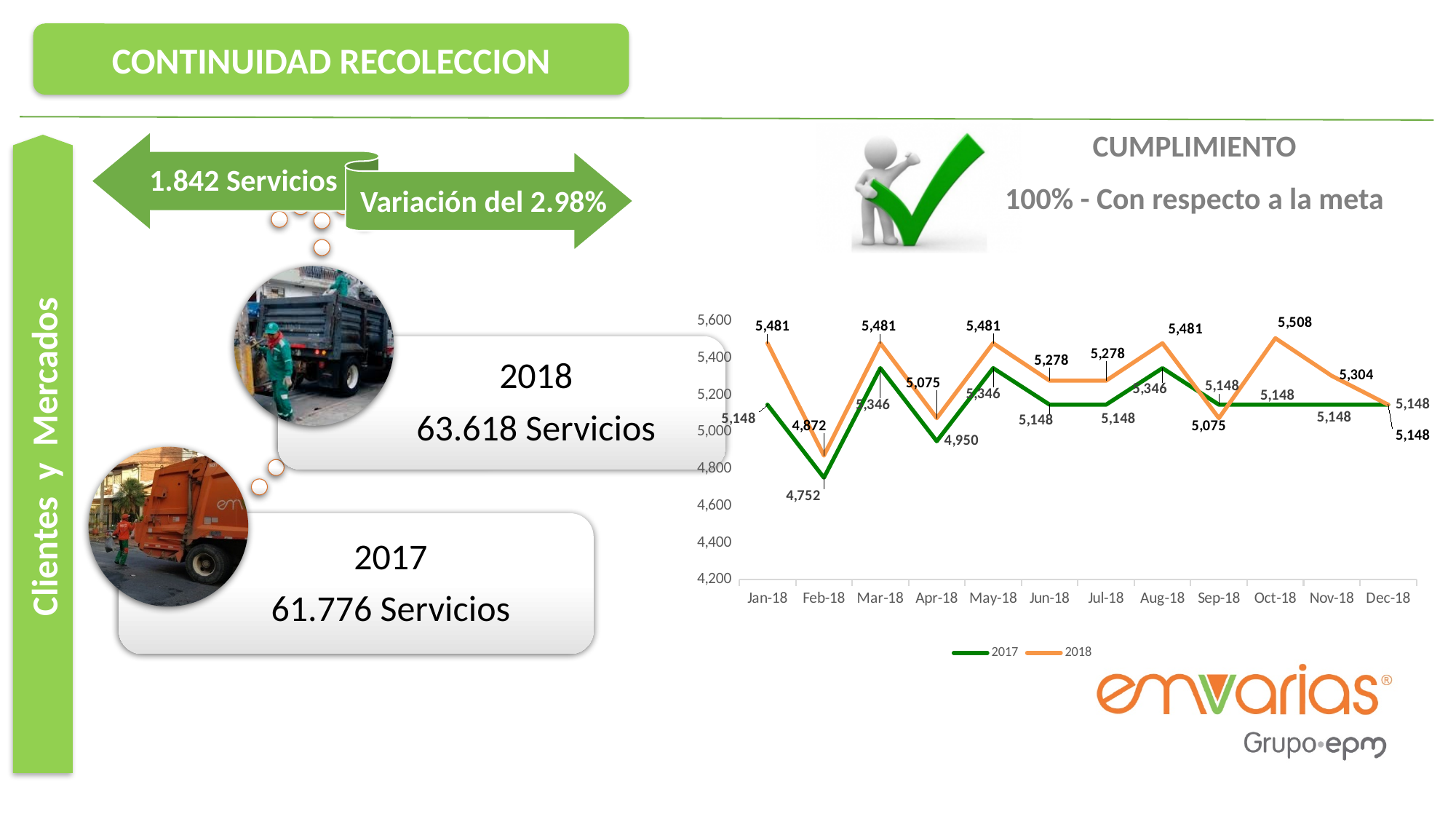
How many series does the chart legend list? 2 In which month does the 2018 series reach its highest value? Oct-18 Does the 2018 series rise or fall from Oct-18 to Dec-18? fall What type of chart is shown on the slide? line chart What is the value for the 2018 series in Oct-18? 5,508 What is the value for the 2017 series in Feb-18? 4,752 How many months are plotted along the x axis of the chart? 12 In which month does the 2017 series reach its lowest value? Feb-18 Which colour is used for the 2018 series in the chart? orange Which series has the larger value in Sep-18, 2017 or 2018? 2017 What is the difference between the 2018 and 2017 values in Jan-18? 333 What is the value for the 2018 series in Jun-18? 5,278